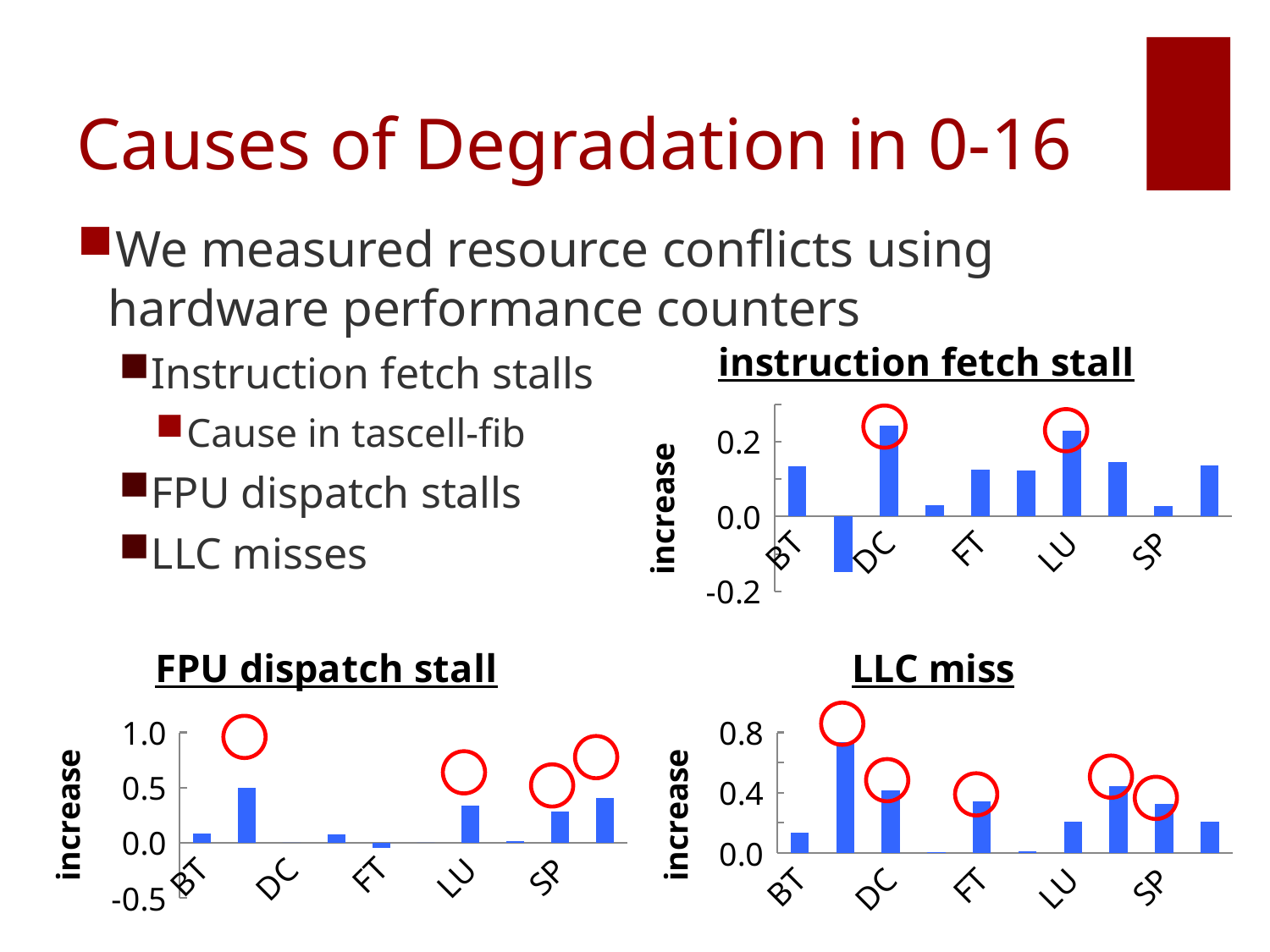
What is the y-axis label on the "LLC miss" chart? increase In the "instruction fetch stall" chart, is the value for DC greater or less than 0.2? greater In the "LLC miss" chart, is the value for LU greater or less than 0.4? less In the "LLC miss" chart, is the value for BT greater or less than 0.4? less What kind of chart is the "instruction fetch stall" chart? bar chart In the "instruction fetch stall" chart, how many bars are plotted? 10 How many charts are shown on the slide? 3 In the "instruction fetch stall" chart, which is larger, the value for DC or the value for SP? DC In the "LLC miss" chart, which is larger, the value for DC or the value for BT? DC In the "FPU dispatch stall" chart, which is larger, the value for LU or the value for BT? LU